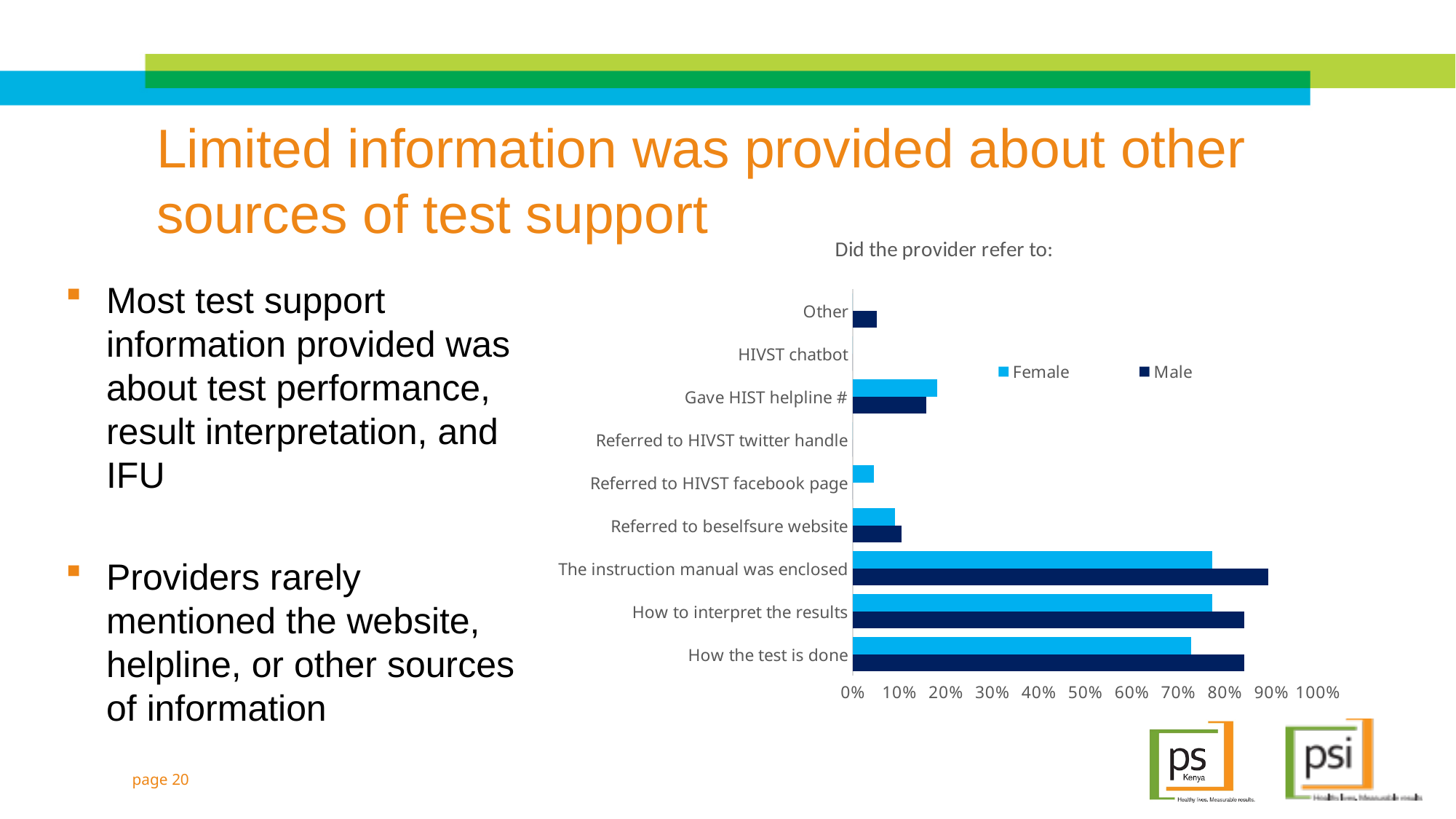
Is the Male value for 'The instruction manual was enclosed' greater or less than 80%? greater Is the Male value for 'How to interpret the results' greater or less than 70%? greater Which series is shown in dark blue in the chart? Male Is the Female value for 'How the test is done' greater or less than 80%? less What kind of chart is shown on the slide? bar chart For 'The instruction manual was enclosed', which is larger, the Female value or the Male value? Male For 'Referred to HIVST facebook page', which is larger, the Female value or the Male value? Female How many series does the chart's legend list? 2 How many categories are shown on the chart's vertical axis? 9 For the Male series, which category has the highest value? The instruction manual was enclosed What is the title of the chart? Did the provider refer to: